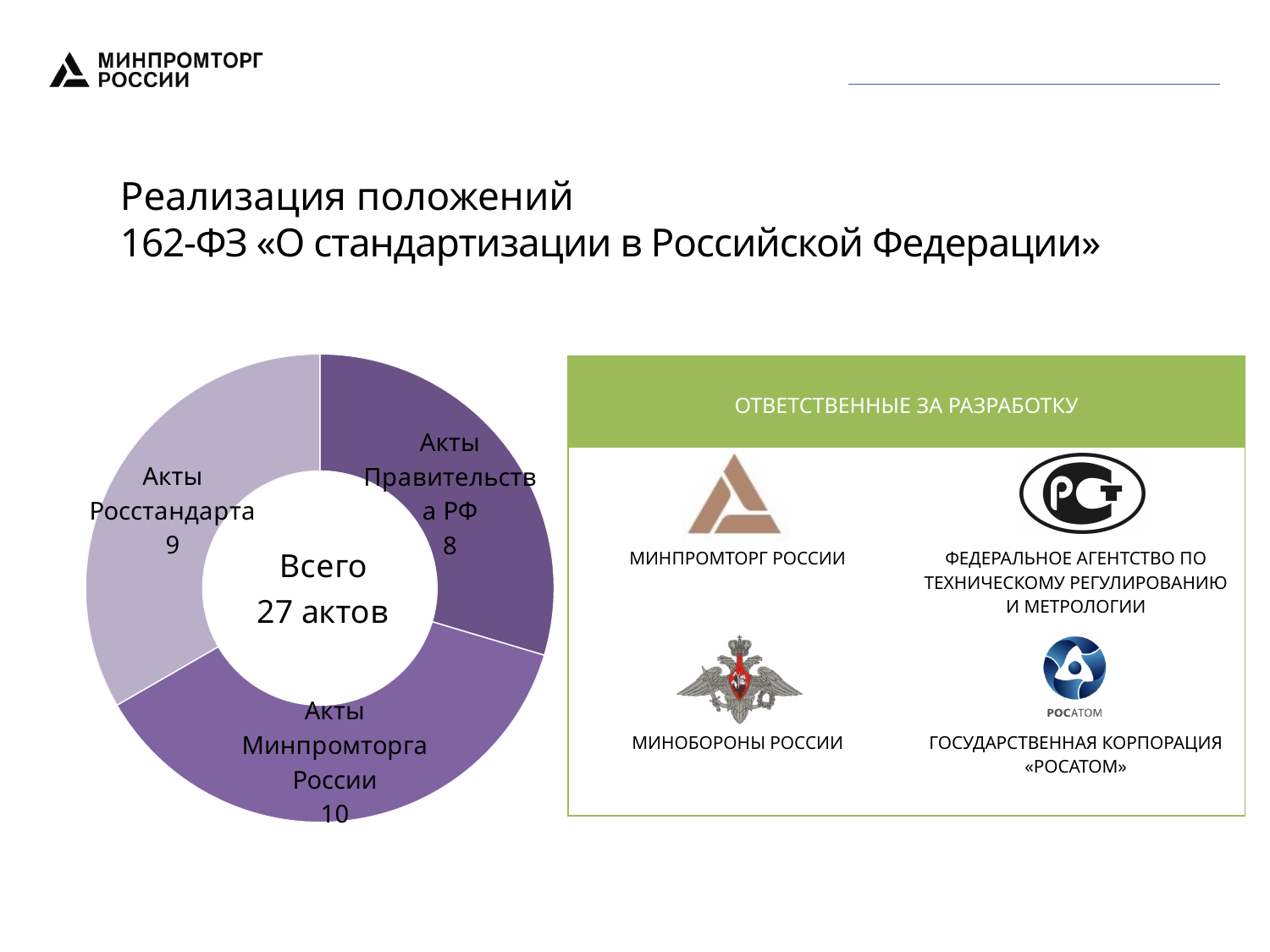
What is the difference between Акты Росстандарта and Акты Правительства РФ? 1 What total is shown in the centre of the doughnut chart? Всего 27 актов What is the value for Акты Правительства РФ? 8 Which category has the lowest value? Акты Правительства РФ How many categories does the doughnut chart show? 3 What is the value for Акты Минпромторга России? 10 What is the title of the slide containing the chart? Реализация положений 162-ФЗ «О стандартизации в Российской Федерации» Which category has the highest value? Акты Минпромторга России What is the value for Акты Росстандарта? 9 What is the difference between Акты Минпромторга России and Акты Правительства РФ? 2 Which is larger: Акты Росстандарта or Акты Правительства РФ? Акты Росстандарта What type of chart is shown on the slide? Doughnut (pie) chart